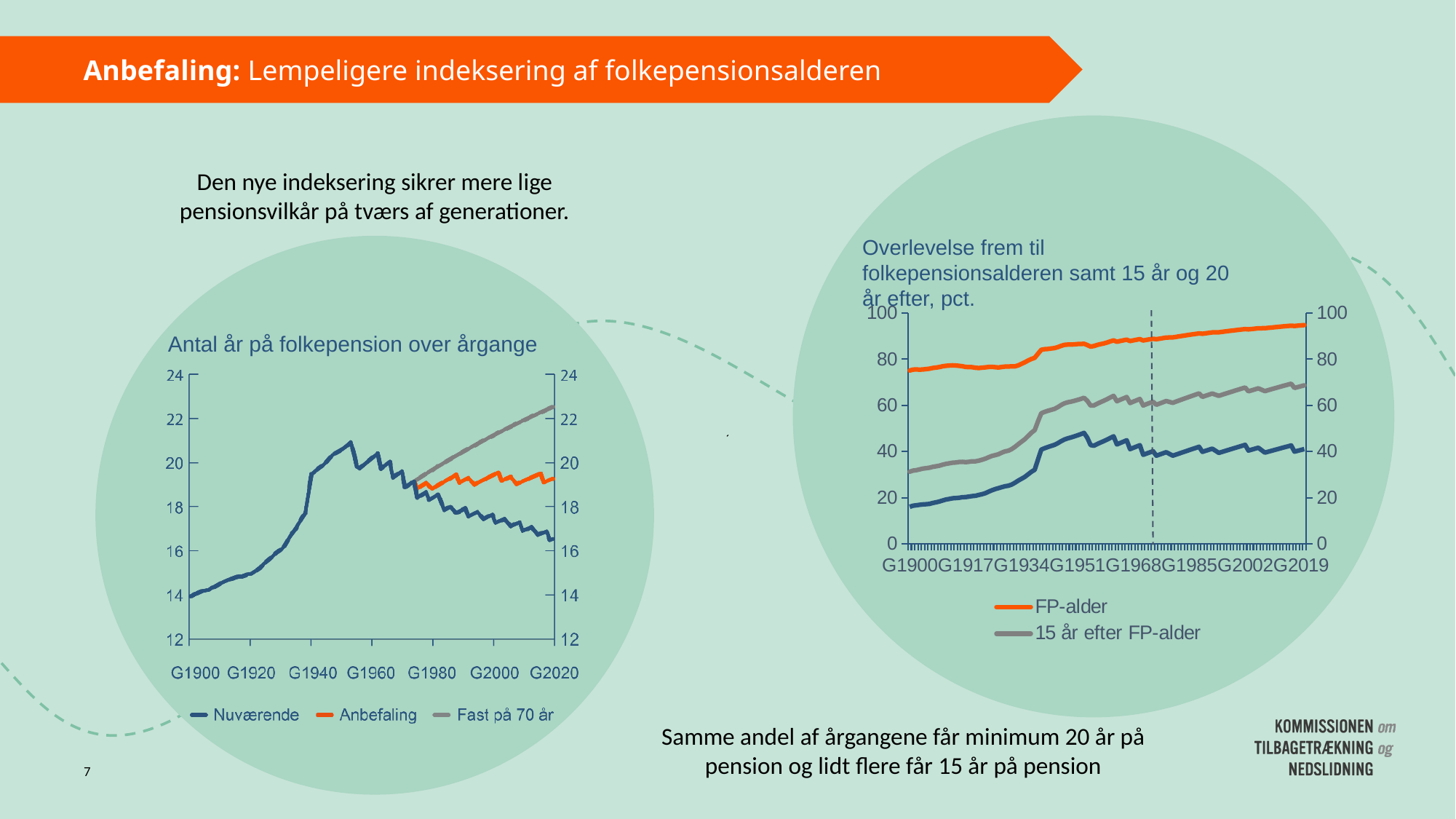
In the chart "Antal år på folkepension over årgange", does the Nuværende series rise or fall from G1980 to G2020? fall In the chart "Antal år på folkepension over årgange", is the value of the Fast på 70 år series at G2020 greater or less than 22? greater What kind of chart is the chart titled "Overlevelse frem til folkepensionsalderen samt 15 år og 20 år efter, pct."? line chart How many series does the legend of the chart "Antal år på folkepension over årgange" list? 3 In the chart "Overlevelse frem til folkepensionsalderen samt 15 år og 20 år efter, pct.", is the value of the 15 år efter FP-alder series at G2019 greater or less than 80? less What kind of chart is the chart titled "Antal år på folkepension over årgange"? line chart In the chart "Overlevelse frem til folkepensionsalderen samt 15 år og 20 år efter, pct.", does the FP-alder series rise or fall from G1900 to G2019? rise In the chart "Antal år på folkepension over årgange", is the value of the Nuværende series at G1900 greater or less than 16? less In the chart "Antal år på folkepension over årgange", which series has the higher value at G2020: Anbefaling or Nuværende? Anbefaling In the chart "Antal år på folkepension over årgange", which series is shown in orange? Anbefaling